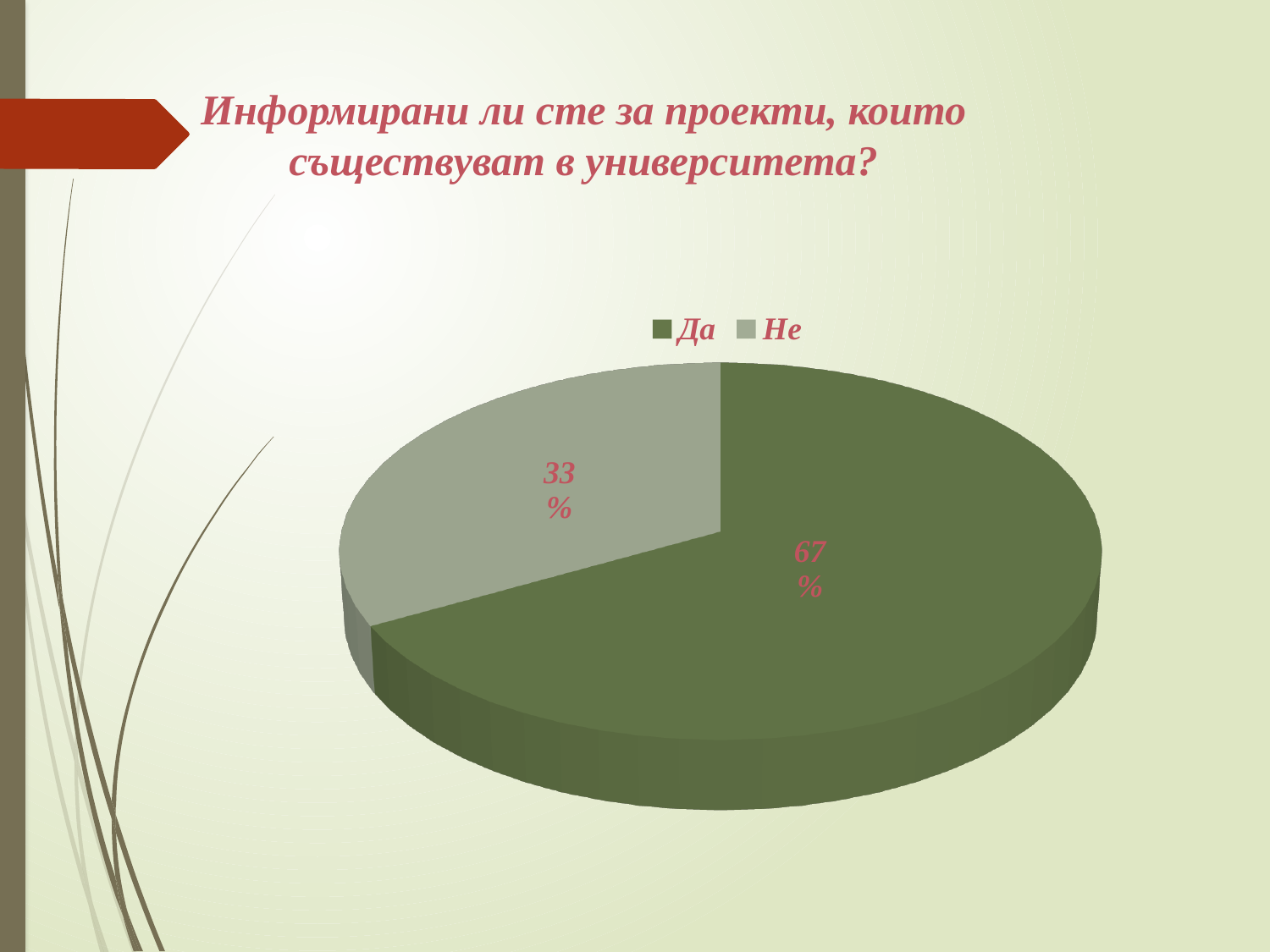
How many slices does the pie chart have? 2 Which is larger, the "Да" slice or the "Не" slice? Да What kind of chart is shown on the slide? pie chart Which slice is the largest? Да Which legend entry is shown in the darker green colour? Да What is the title of the slide above the chart? Информирани ли сте за проекти, които съществуват в университета? What is the difference in percentage points between the "Да" and "Не" slices? 34% What share of the pie does "Не" represent? 33% Which slice is the smallest? Не What share of the pie does "Да" represent? 67% How many entries does the legend list? 2